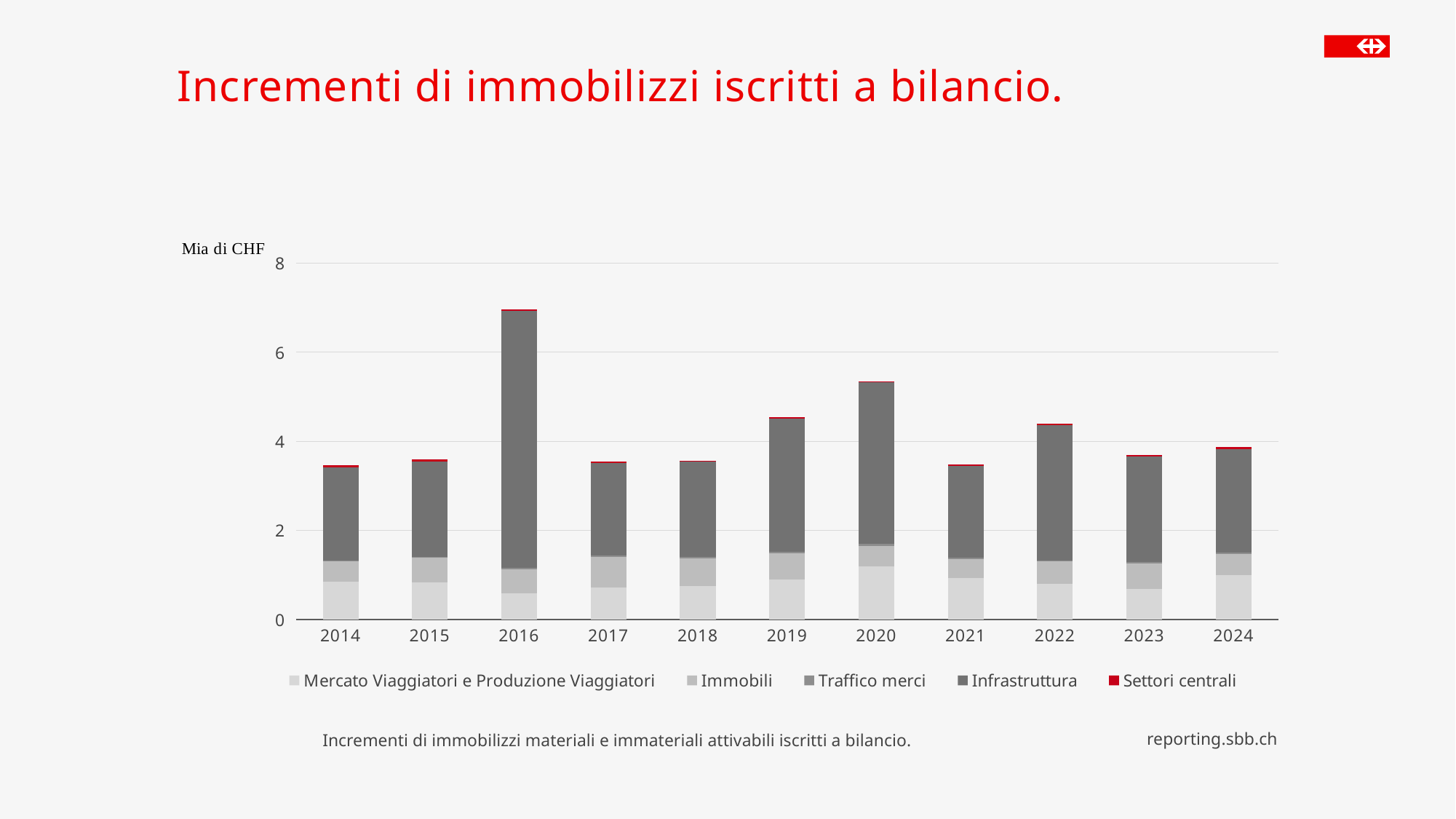
What unit is shown on the y axis of the chart? Mia di CHF Is the total value for 2023 greater or less than 4? less How many series does the chart's legend list? 5 What kind of chart is shown on the slide? Stacked bar chart Is the total value for 2018 greater or less than 4? less Is the total value for 2020 greater or less than 4? greater Which year has the highest total bar in the chart? 2016 Which year has the larger total bar, 2020 or 2019? 2020 Which legend series is shown in red? Settori centrali How many years are shown on the x axis of the chart? 11